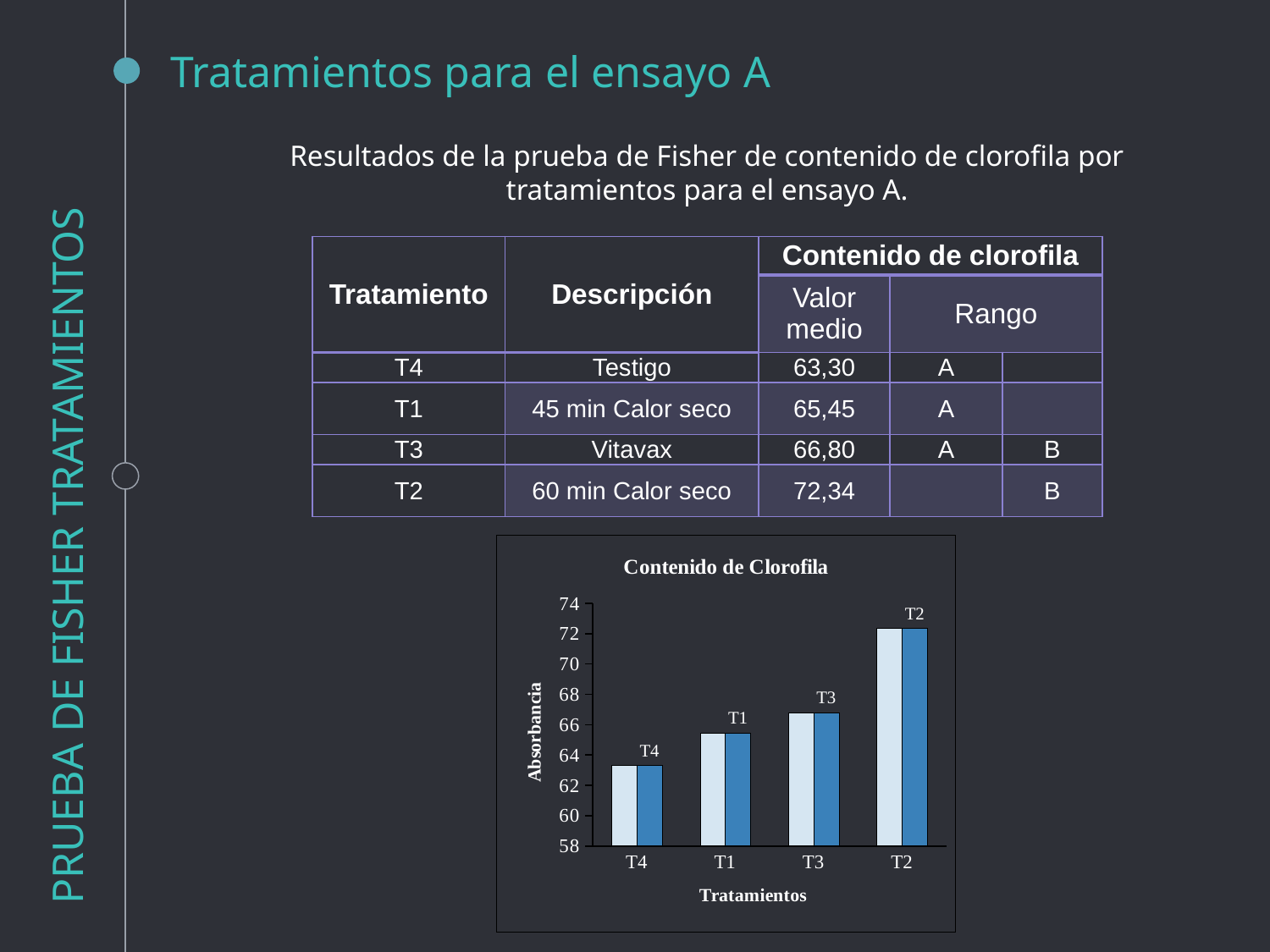
Is the value for T2 in the chart greater or less than 70? greater Which treatment has the lowest bar in the chart? T4 Is the value for T3 in the chart greater or less than 66? greater Which treatment has the highest bar in the chart? T2 Is the value for T4 in the chart greater or less than 64? less What is the title of the chart? Contenido de Clorofila Do the bar values rise or fall moving left to right along the x axis from T4 to T2? rise How many treatment categories are plotted on the x axis of the chart? 4 What is the label of the y axis of the chart? Absorbancia Which is larger in the chart, the value for T1 or the value for T3? T3 What kind of chart is shown on the slide? bar chart